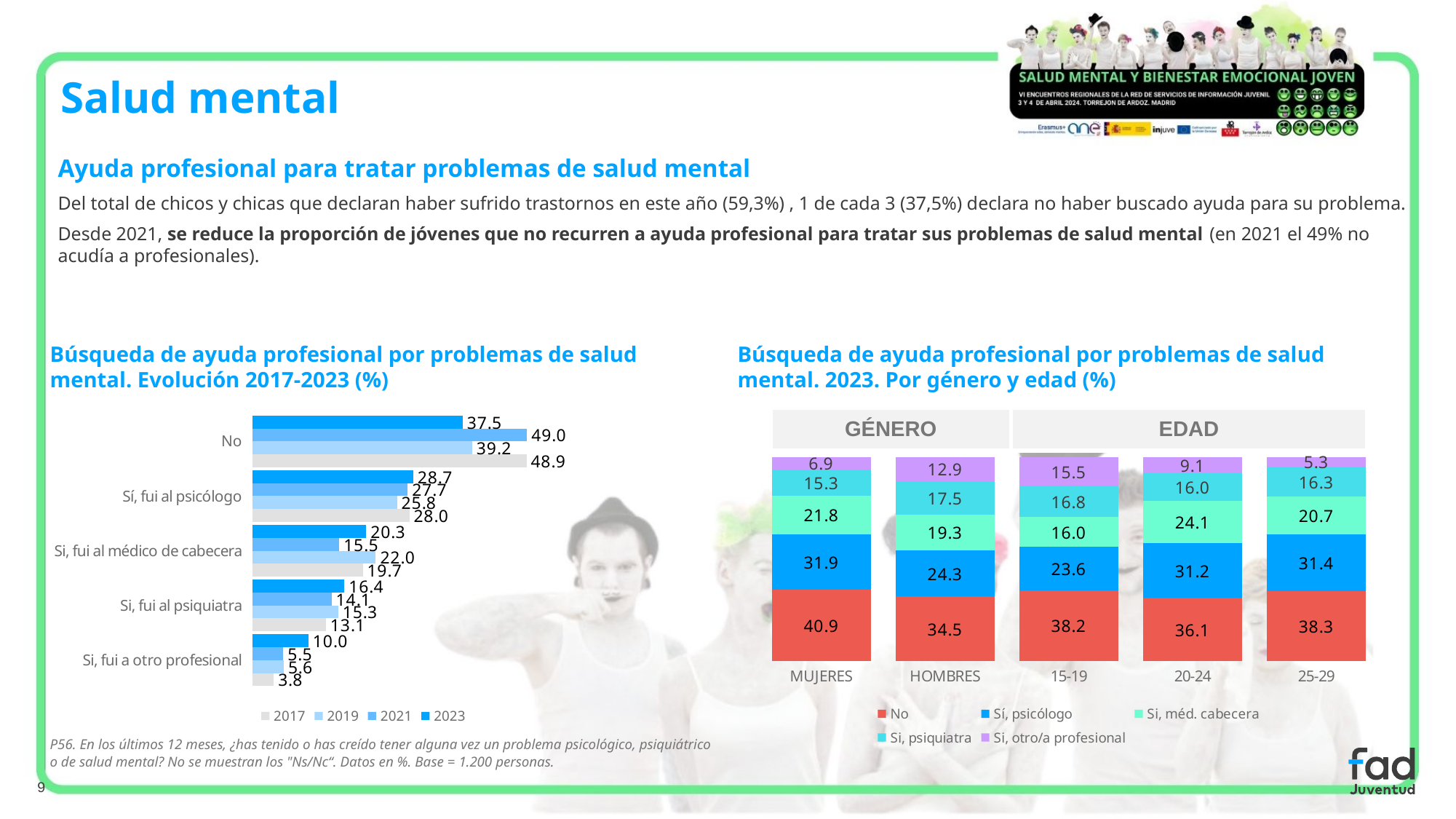
In the right chart (2023. Por género y edad), is the "No" value larger for MUJERES or HOMBRES? MUJERES In the right chart (2023. Por género y edad), what is the "No" value for MUJERES? 40.9 In the left chart (Evolución 2017-2023), how many series does the legend list? 4 In the right chart (2023. Por género y edad), how many categories are shown on the x axis? 5 In the right chart (2023. Por género y edad), which category has the lowest "Si, otro/a profesional" value? 25-29 In the left chart (Evolución 2017-2023), which year has the highest value for "Si, fui al psiquiatra"? 2023 In the right chart (2023. Por género y edad), what is the "Sí, psicólogo" value for 20-24? 31.2 In the left chart (Evolución 2017-2023), what is the difference between the 2023 and 2021 values for "No"? 11.5 In the left chart (Evolución 2017-2023), what is the 2021 value for "No"? 49.0 What kind of chart is the left chart (Evolución 2017-2023)? Bar chart In the left chart (Evolución 2017-2023), what is the 2017 value for "Si, fui a otro profesional"? 3.8 In the left chart (Evolución 2017-2023), what is the 2023 value for "No"? 37.5